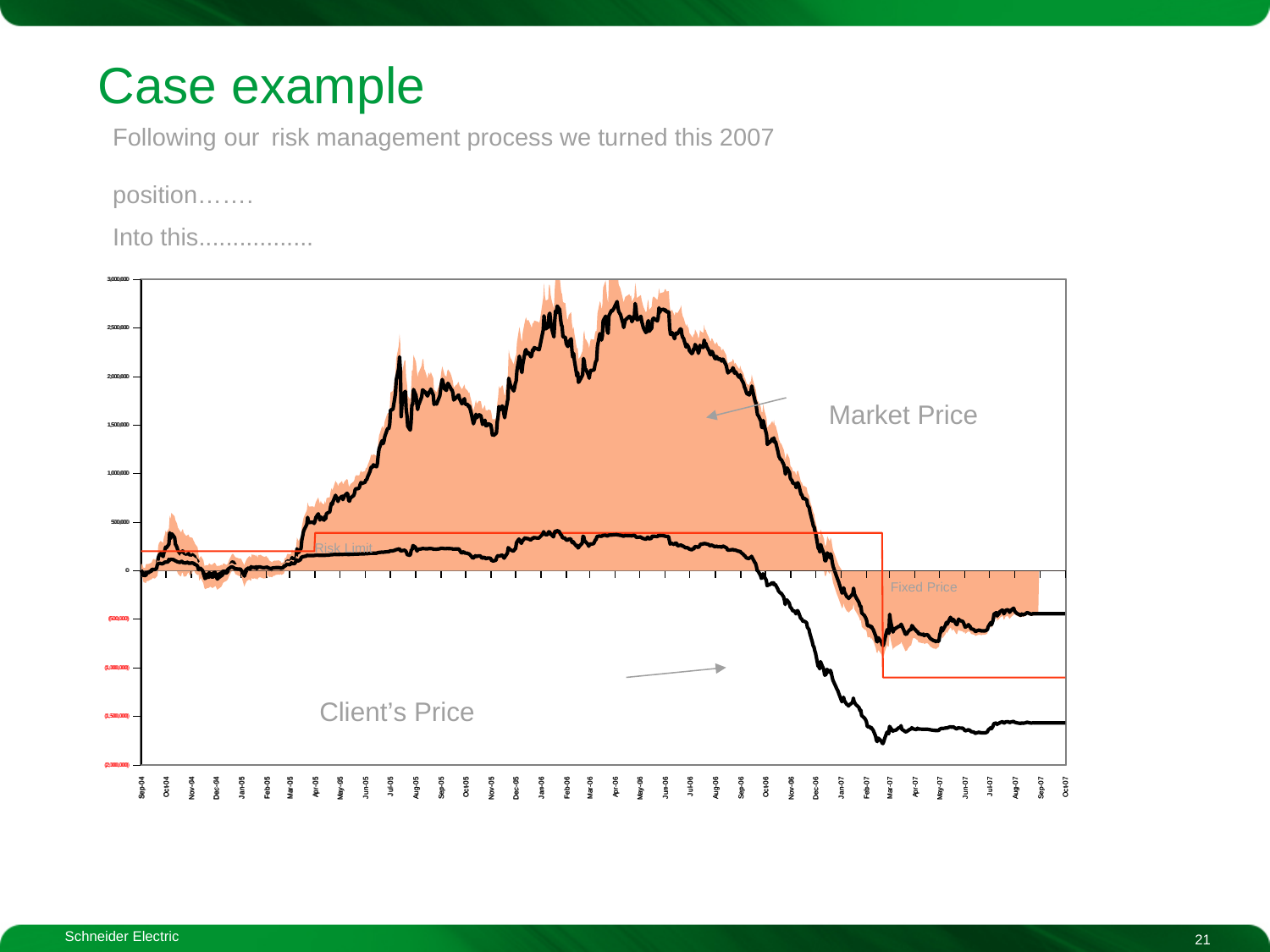
What is the last month label on the x axis of the chart? Oct-07 Does the Market Price rise or fall between Sep-06 and Feb-07? fall Does the Market Price rise or fall between Mar-05 and Apr-06? rise What kind of chart is shown on the slide? line chart In Jul-07, which is higher: the Market Price or the Client's Price? Client's Price What label is shown inside the shaded area below the zero line on the right side of the chart? Fixed Price What is the highest value shown on the y axis of the chart? 3,000,000 Is the Market Price in Apr-06 greater or less than 2,000,000? greater Is the Market Price in Jul-05 greater or less than 1,000,000? greater What does the red stepped line on the chart represent? Risk Limit What is the first month label on the x axis of the chart? Sep-04 Is the Client's Price in Jul-07 above or below 0? below